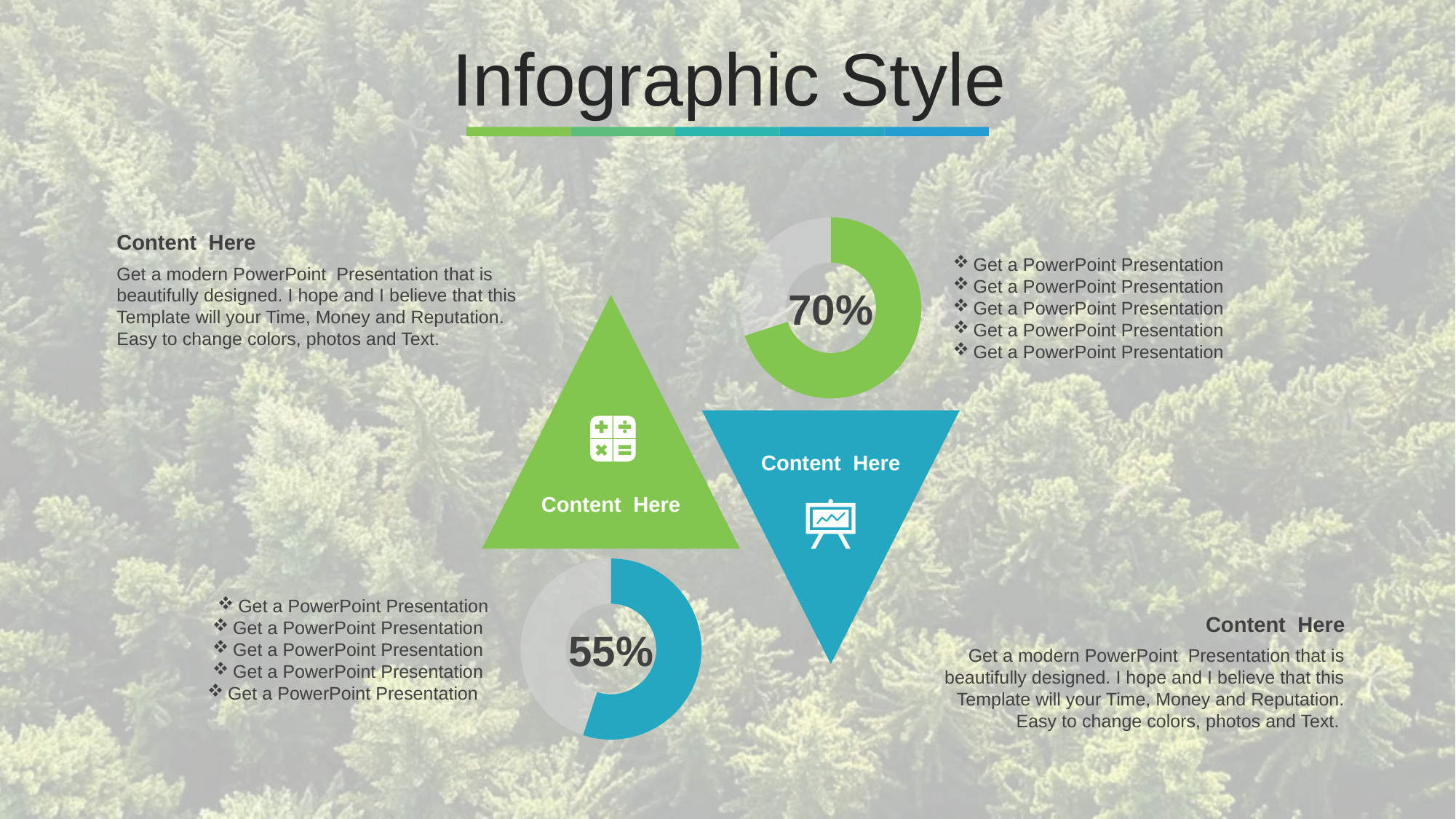
What percentage is shown in the upper doughnut chart? 70% What colour is the filled portion of the doughnut chart showing 70%? green What is the difference between the percentages shown in the upper and lower doughnut charts? 15% Is the value shown in the upper doughnut chart greater or less than 75%? less How many doughnut charts are on the slide? 2 Which doughnut chart shows the smaller percentage, the one with the green ring or the one with the blue ring? the one with the blue ring What percentage is shown in the lower doughnut chart? 55% Is the value shown in the lower doughnut chart greater or less than 50%? greater Which doughnut chart shows the larger percentage, the upper one or the lower one? the upper one What kind of chart is used to display the 70% value? doughnut chart What colour is the filled portion of the doughnut chart showing 55%? blue